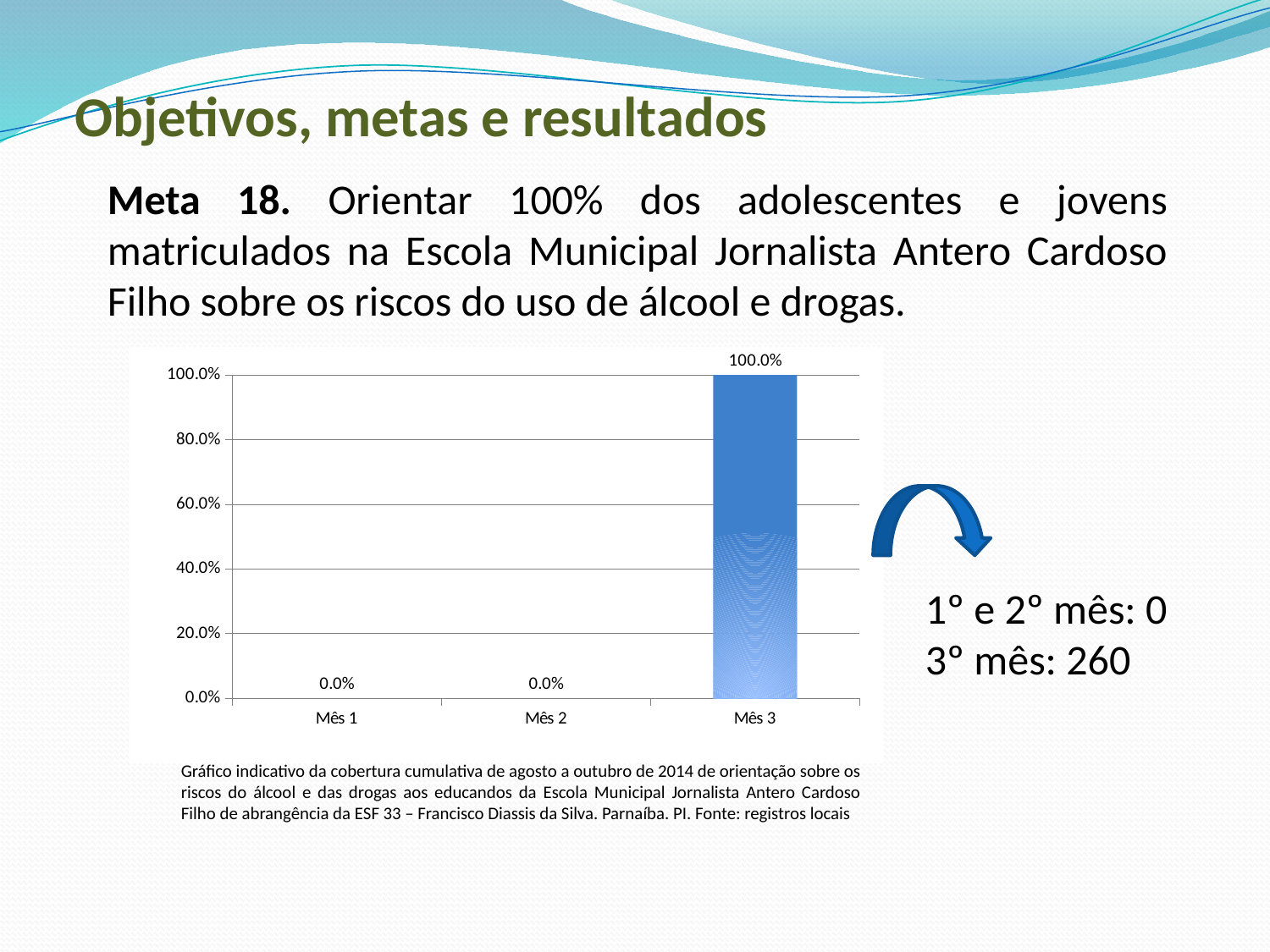
What is the value for Mês 3? 100.0% What is the highest tick value shown on the y axis? 100.0% What is the value for Mês 2? 0.0% Do the values rise or fall from Mês 1 to Mês 3? rise What is the difference between the values for Mês 3 and Mês 2? 100.0% Is the value for Mês 3 greater or less than 80.0%? greater How many categories are shown on the x axis? 3 What colour is the bar for Mês 3? blue What is the value for Mês 1? 0.0% Which month has the highest value? Mês 3 Which is larger, the value for Mês 1 or the value for Mês 3? Mês 3 What kind of chart is shown on the slide? bar chart